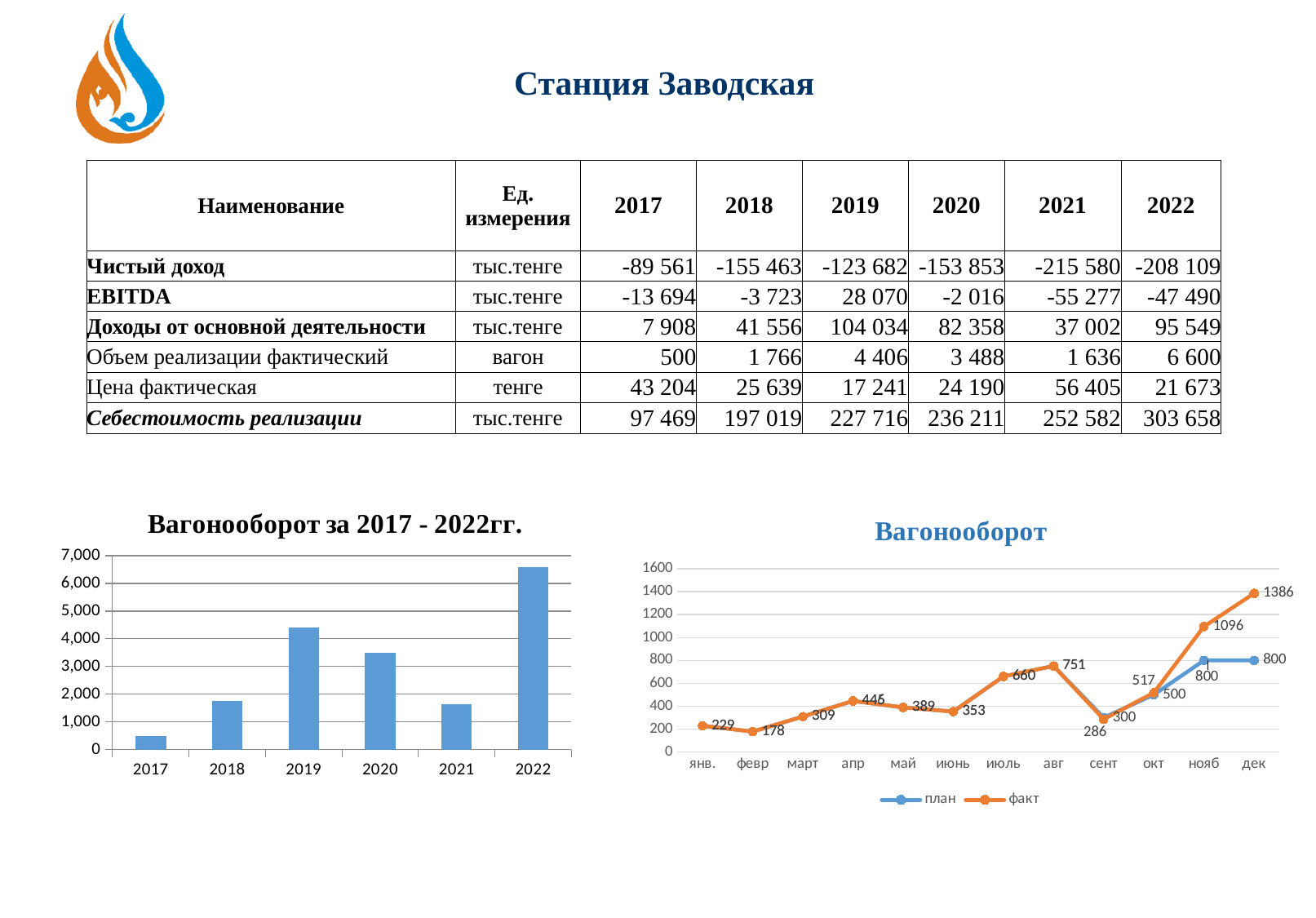
In the chart "Вагонооборот за 2017 - 2022гг.", is the value for 2021 greater or less than 2,000? less How many series does the legend of the chart titled "Вагонооборот" list? 2 In the chart titled "Вагонооборот", what is the план value for дек? 800 How many years are shown on the x axis of the chart "Вагонооборот за 2017 - 2022гг."? 6 In the chart "Вагонооборот за 2017 - 2022гг.", which is larger, the bar for 2019 or the bar for 2020? 2019 In the chart titled "Вагонооборот", in which month is the факт value lowest? февр In the chart titled "Вагонооборот", what is the факт value for дек? 1386 In the chart "Вагонооборот за 2017 - 2022гг.", is the value for 2019 greater or less than 4,000? greater What type of chart is the chart titled "Вагонооборот за 2017 - 2022гг."? bar chart In the chart "Вагонооборот за 2017 - 2022гг.", which year has the lowest bar? 2017 In the chart "Вагонооборот за 2017 - 2022гг.", which year has the highest bar? 2022 In the chart titled "Вагонооборот", what is the difference between the факт and план values for дек? 586